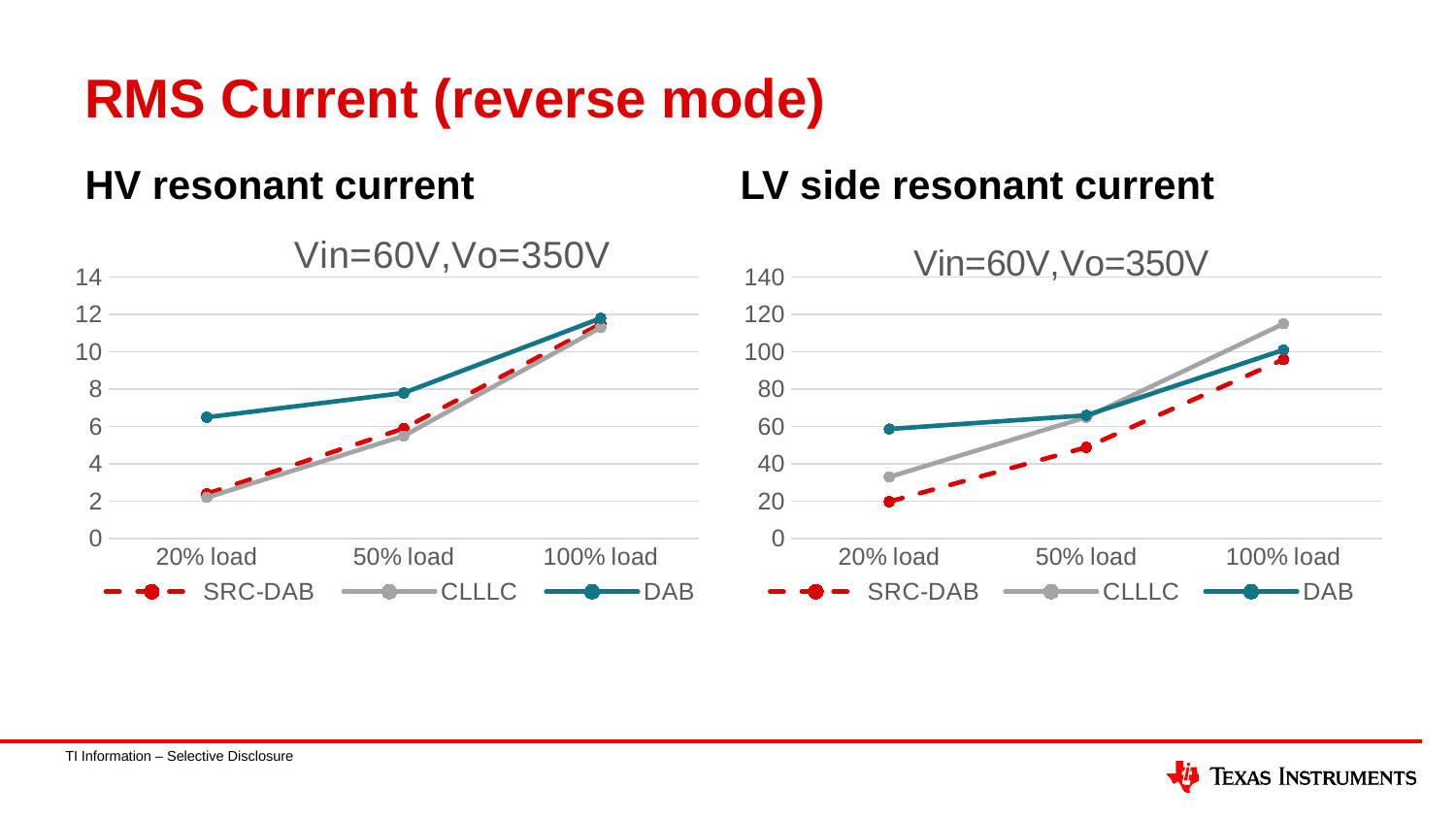
In the HV resonant current chart on the left, does the DAB series rise or fall from 20% load to 100% load? rise In the HV resonant current chart on the left, is the DAB value at 20% load greater or less than 4? greater In the HV resonant current chart on the left, is the CLLLC value at 50% load greater or less than 8? less In the HV resonant current chart on the left, which series has the highest value at 20% load? DAB In the HV resonant current chart on the left, how many load categories are shown on the x axis? 3 In the LV side resonant current chart on the right, does the CLLLC series rise or fall from 20% load to 100% load? rise In the LV side resonant current chart on the right, is the CLLLC value at 100% load greater or less than 100? greater In the LV side resonant current chart on the right, which series has the lowest value at 20% load? SRC-DAB In the LV side resonant current chart on the right, which is larger at 100% load, CLLLC or SRC-DAB? CLLLC In the HV resonant current chart on the left, what kind of chart is shown? line chart In the LV side resonant current chart on the right, how many series does the legend list? 3